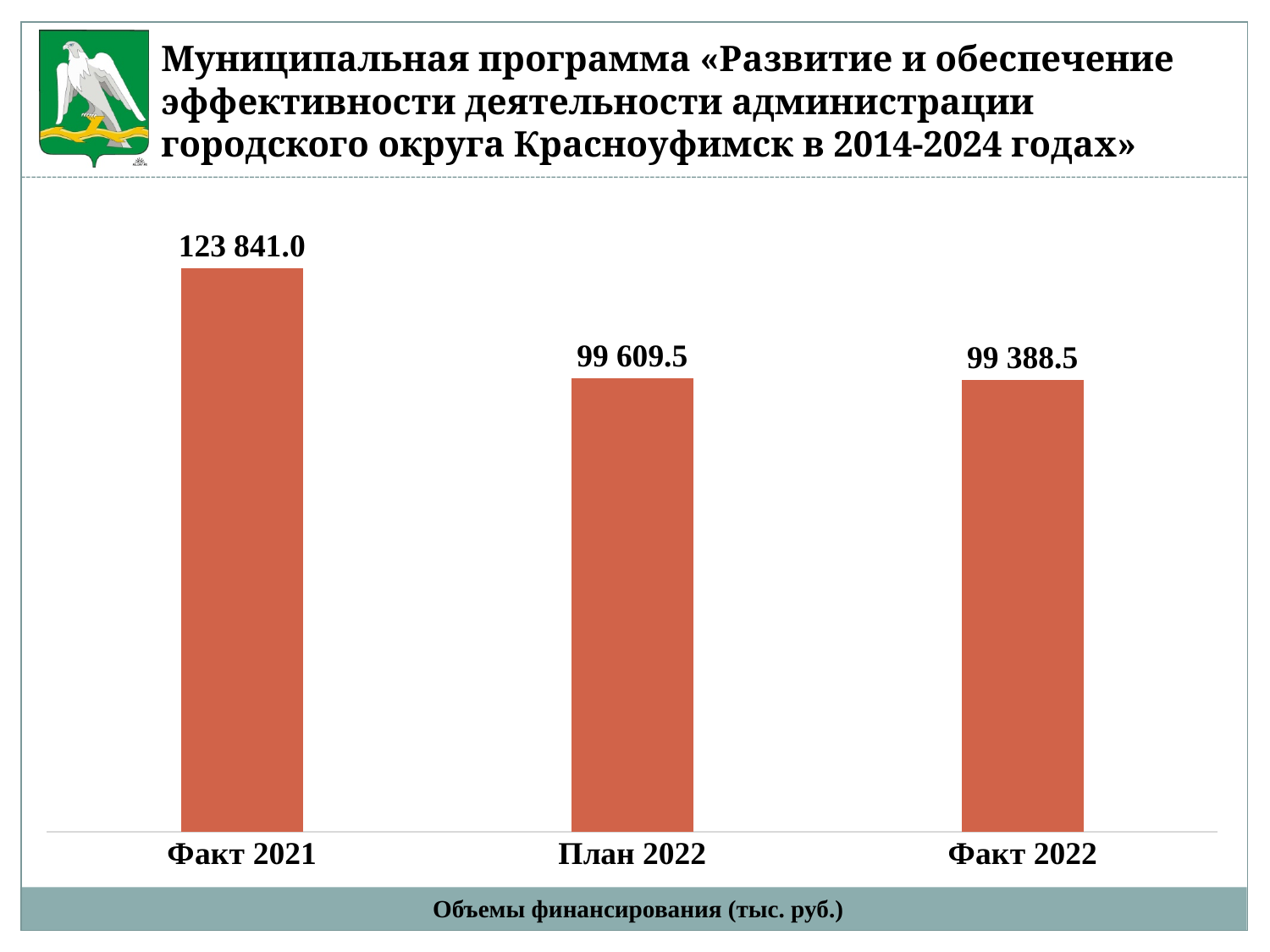
What is the difference between the values for Факт 2021 and План 2022? 24 231.5 Do the values rise or fall from Факт 2021 to Факт 2022? Fall What is the value for Факт 2022? 99 388.5 What is the value for Факт 2021? 123 841.0 What is the difference between the values for План 2022 and Факт 2022? 221.0 What kind of chart is shown on the slide? Bar chart What unit of measurement is given in the caption below the chart? тыс. руб. What is the value for План 2022? 99 609.5 Which category has the highest value? Факт 2021 Which is larger, the value for План 2022 or the value for Факт 2022? План 2022 Which category has the lowest value? Факт 2022 How many categories are shown in the chart? 3